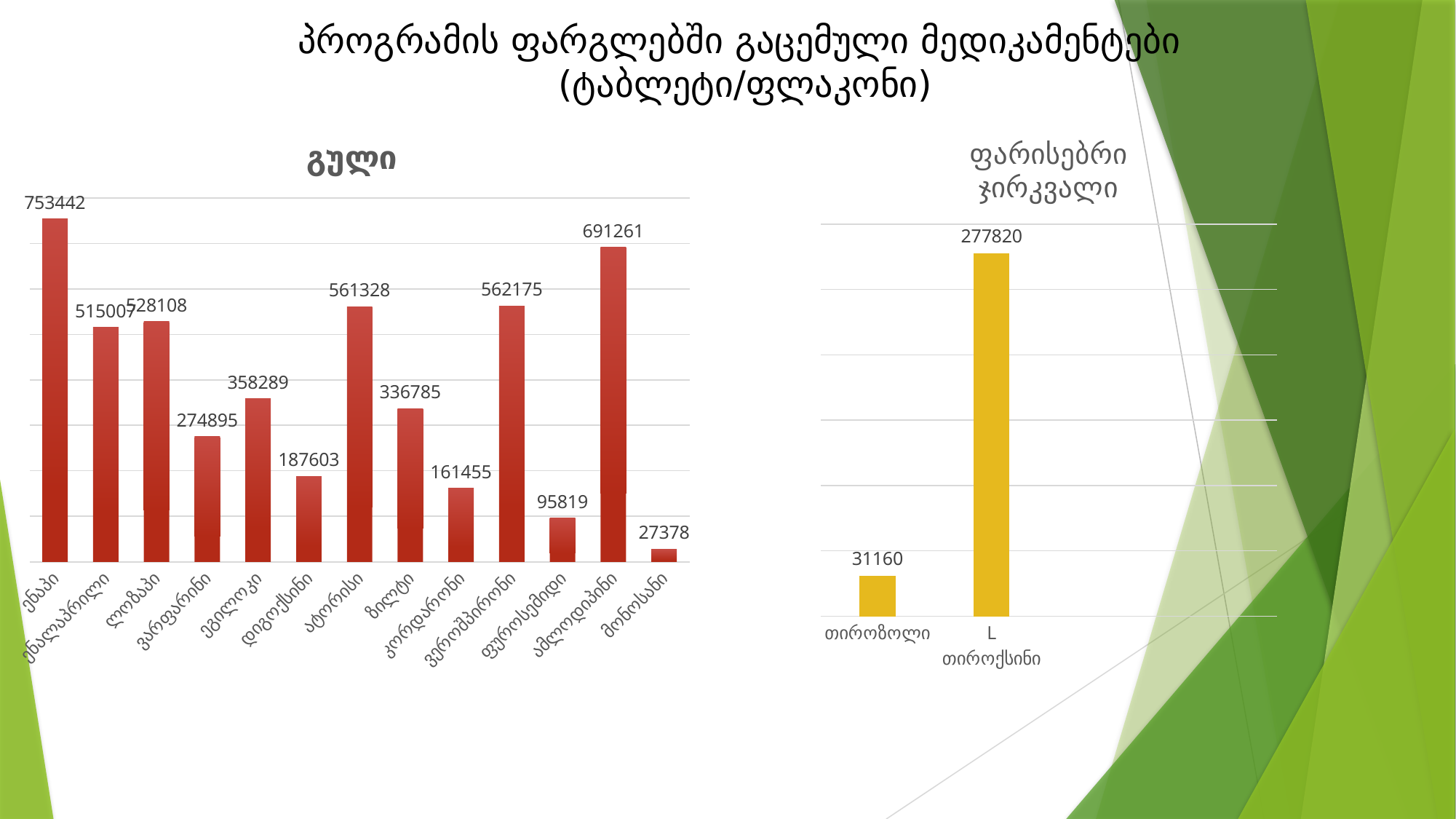
In the chart titled "გული", which category has the lowest value? მონოსანი In the chart titled "გული", what is the value for ენაპი? 753442 In the chart titled "გული", what is the value for ამლოდიპინი? 691261 In the chart titled "გული", what is the difference between the values for ატორისი and ზილტი? 224543 In the chart titled "ფარისებრი ჯირკვალი", what is the value for L თიროქსინი? 277820 In the chart titled "ფარისებრი ჯირკვალი", how many categories are shown? 2 In the chart titled "გული", what is the value for დიგოქსინი? 187603 In the chart titled "გული", which category has the highest value? ენაპი In the chart titled "ფარისებრი ჯირკვალი", what is the difference between the values for L თიროქსინი and თიროზოლი? 246660 In the chart titled "გული", which is larger, the value for ეგილოკი or the value for ვარფარინი? ეგილოკი What type of chart is the chart titled "ფარისებრი ჯირკვალი"? bar chart In the chart titled "გული", how many categories are shown? 13